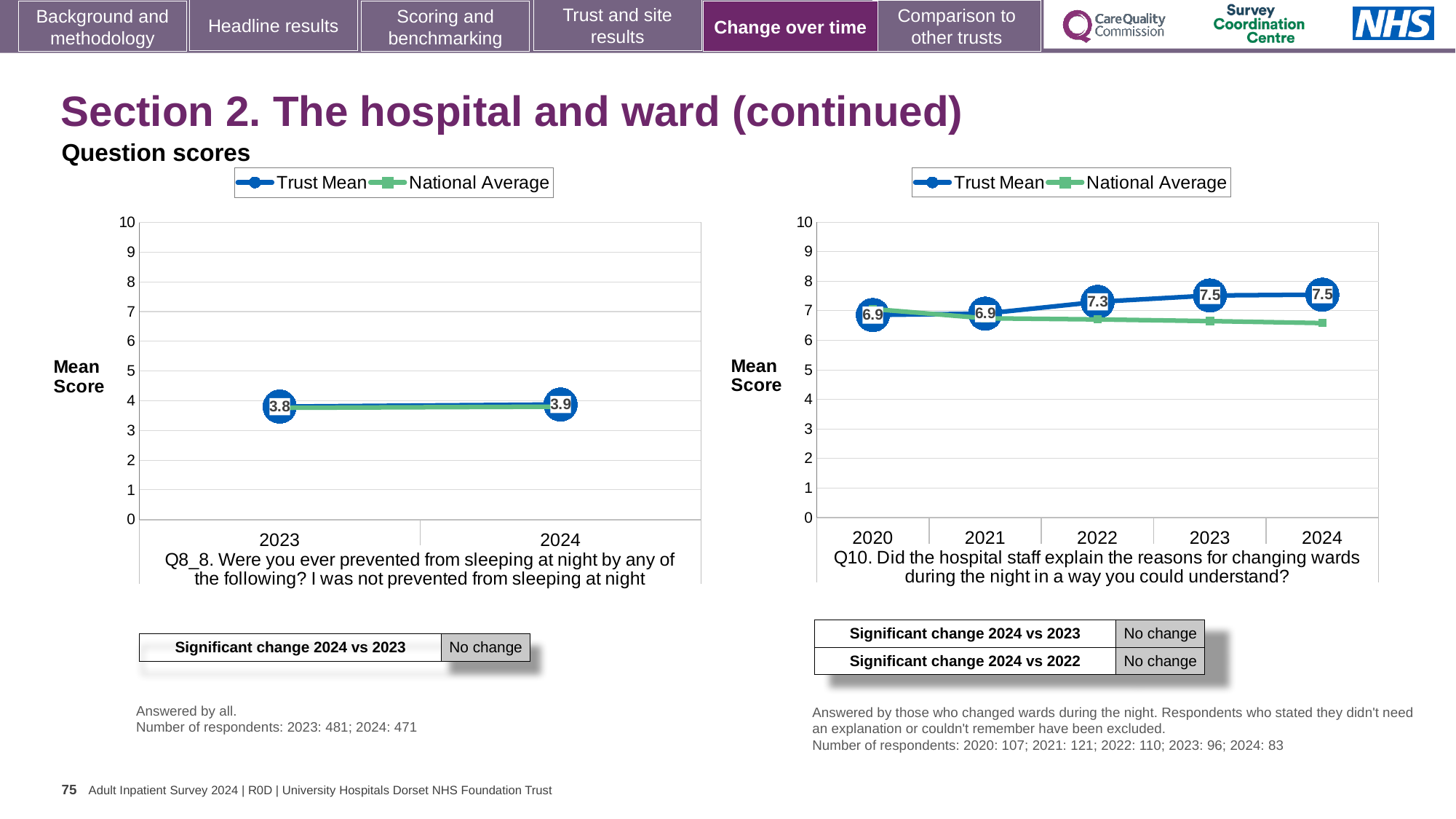
In the Q10 chart on the right, is the National Average value for 2024 greater or less than 7? less In the Q10 chart on the right, does the Trust Mean score rise or fall from 2020 to 2024? Rise In the Q8_8 chart on the left, what is the Trust Mean score for 2024? 3.9 What kind of chart is the Q10 chart on the right? Line chart In the Q10 chart on the right, which year has the higher Trust Mean score, 2022 or 2024? 2024 In the Q10 chart on the right, what is the Trust Mean score for 2022? 7.3 How many series does the legend of the Q8_8 chart on the left list? 2 In the Q10 chart on the right, what is the Trust Mean score for 2020? 6.9 How many years are shown on the x axis of the Q10 chart on the right? 5 In the Q8_8 chart on the left, which year has the higher Trust Mean score, 2023 or 2024? 2024 In the Q8_8 chart on the left, what is the Trust Mean score for 2023? 3.8 In the Q10 chart on the right, what is the difference between the Trust Mean scores for 2024 and 2020? 0.6